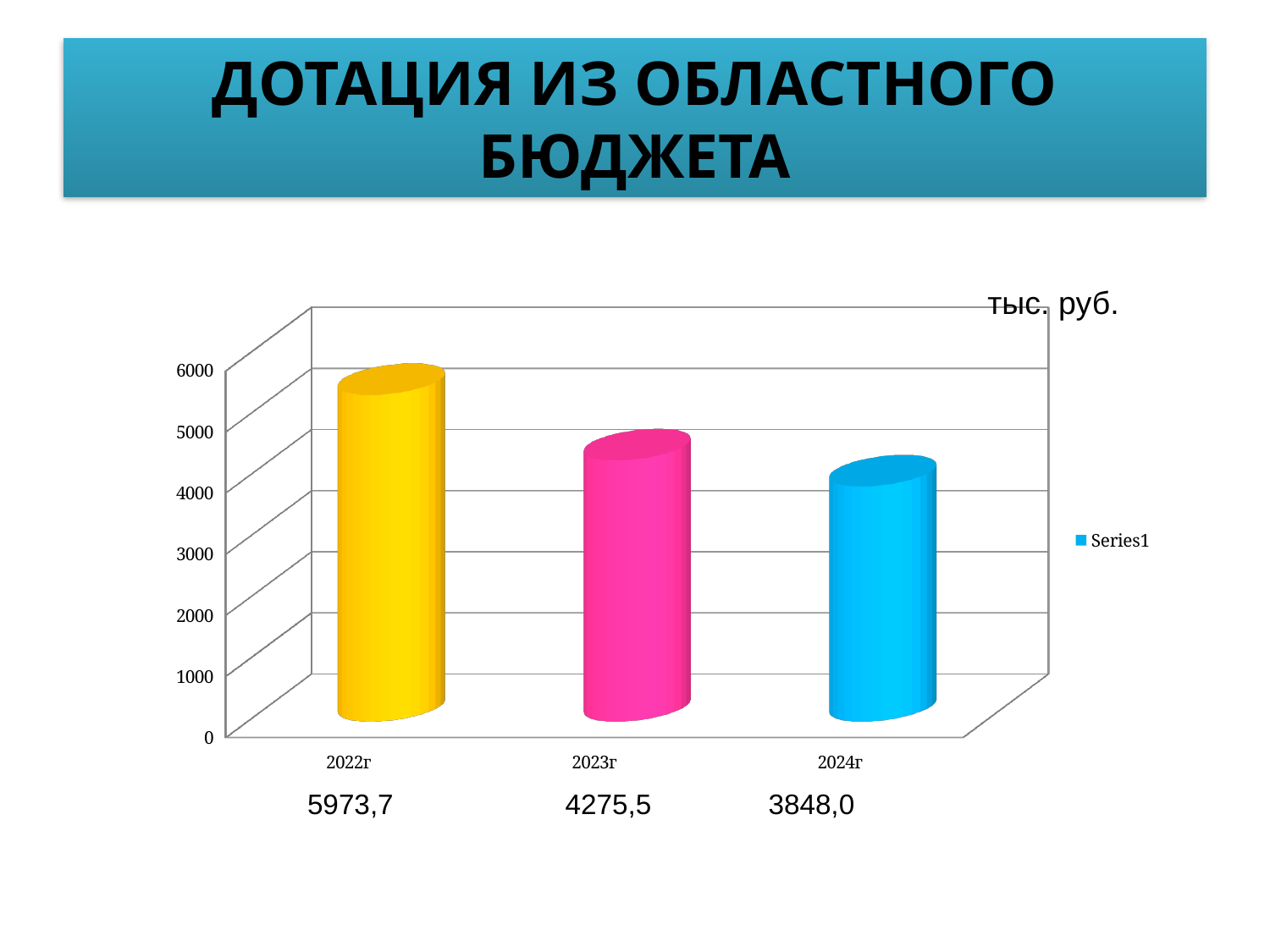
Do the values rise or fall from 2022г to 2024г? fall Which is larger, the value for 2023г or the value for 2024г? 2023г What kind of chart is shown on the slide? bar chart What is the value for 2023г? 4275,5 Which year has the lowest value? 2024г Is the value for 2022г greater or less than 5000? greater What is the difference between the values for 2022г and 2023г? 1698,2 What is the value for 2022г? 5973,7 How many years are shown on the chart? 3 What is the difference between the values for 2023г and 2024г? 427,5 What is the value for 2024г? 3848,0 Which year has the highest value? 2022г